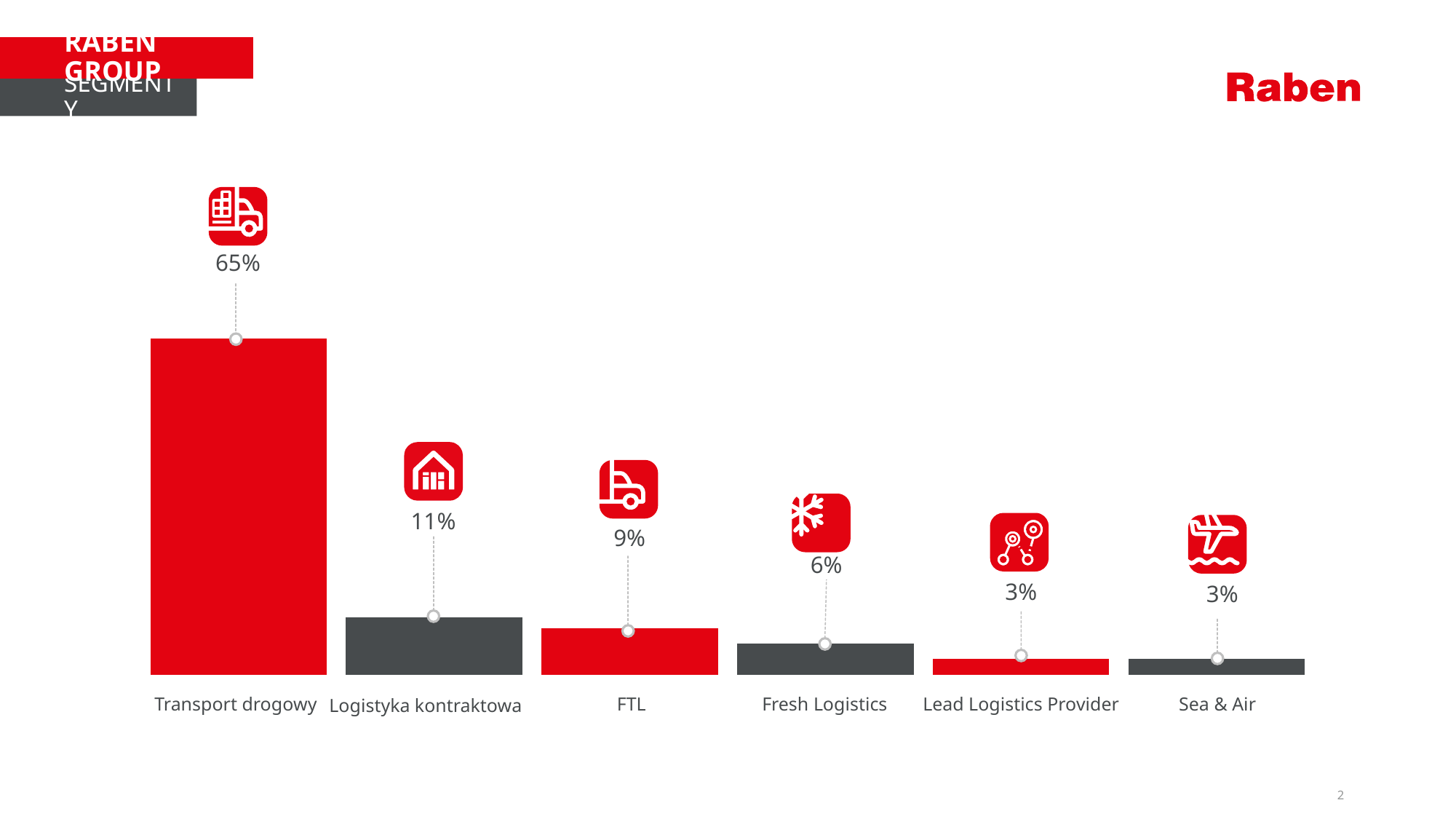
What is the difference between the values for FTL and Fresh Logistics? 3% What is the value for Logistyka kontraktowa? 11% Do the values rise or fall from left to right along the x axis? Fall What is the value for Transport drogowy? 65% Which is larger, the value for Logistyka kontraktowa or the value for FTL? Logistyka kontraktowa Which category has the highest value? Transport drogowy How many categories are shown in the chart? 6 What is the value for Lead Logistics Provider? 3% What is the value for Fresh Logistics? 6% What kind of chart is shown on the slide? Bar chart What is the difference between the values for Transport drogowy and Logistyka kontraktowa? 54% What is the value for FTL? 9%